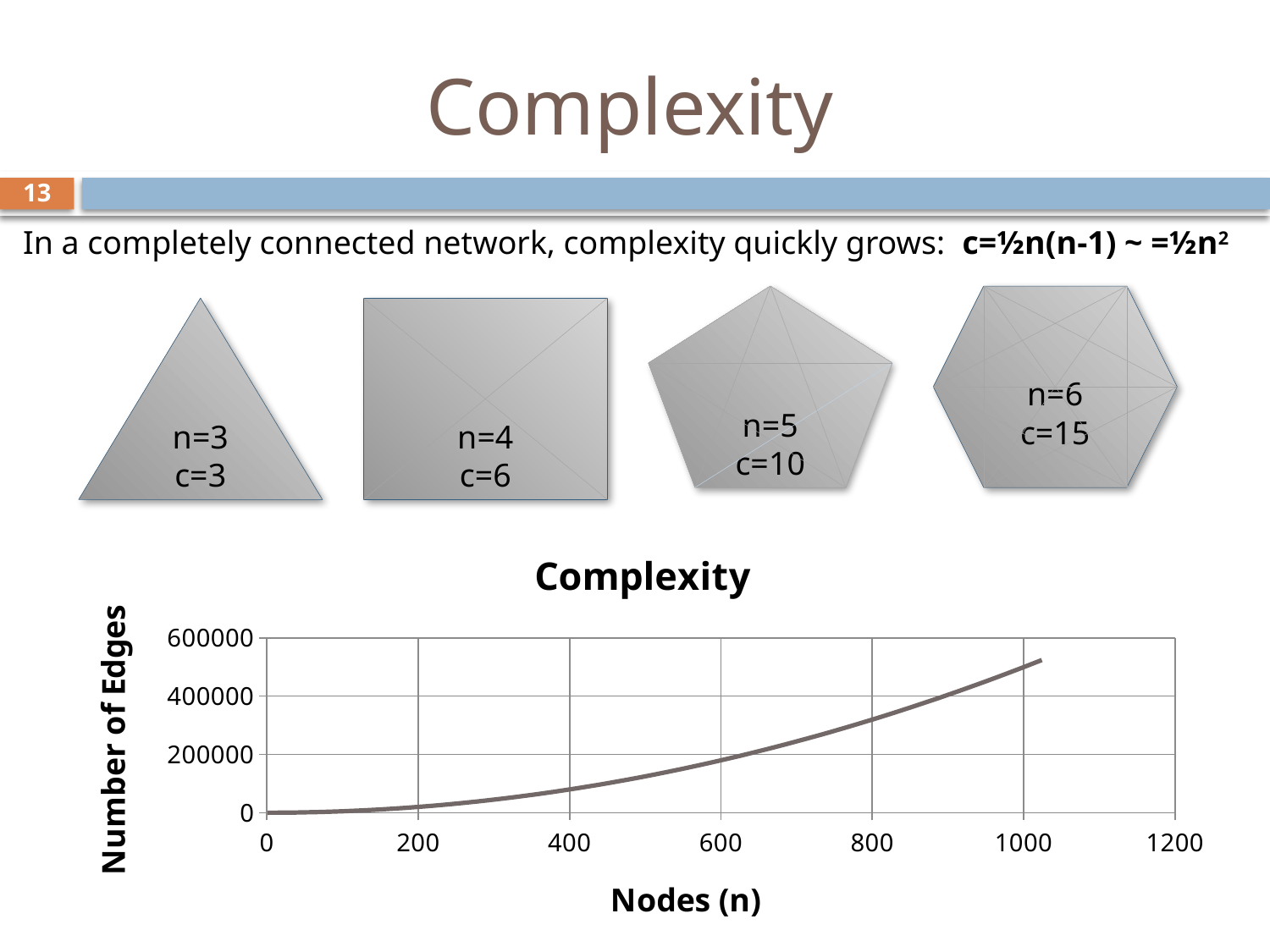
In the Complexity chart, does the number of edges rise or fall as the number of nodes increases? rise How many lines are plotted in the Complexity chart? 1 What is the title of the chart at the bottom of the slide? Complexity What is the label of the x axis of the Complexity chart? Nodes (n) In the Complexity chart, is the number of edges at 400 nodes greater or less than 200000? less What kind of chart is shown under the title "Complexity"? line chart In the Complexity chart, is the number of edges at 800 nodes greater or less than 400000? less In the Complexity chart, is the number of edges at 1000 nodes greater or less than 400000? greater In the Complexity chart, which has more edges: 600 nodes or 1000 nodes? 1000 nodes What is the highest value shown on the y axis of the Complexity chart? 600000